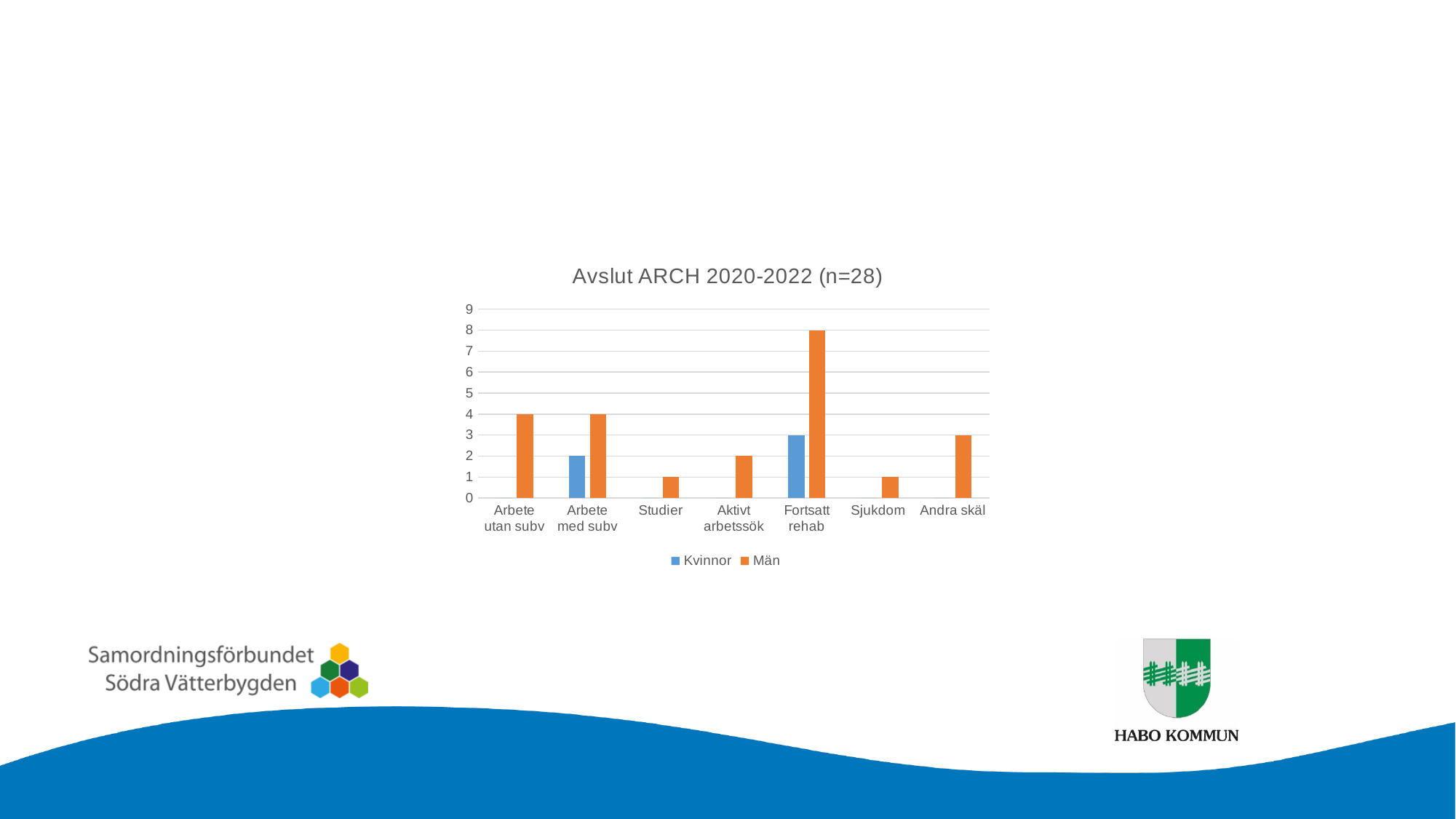
Which category has the highest value for Män? Fortsatt rehab What is the difference between the Män and Kvinnor values in the Fortsatt rehab category? 5 Is the value for Män in the Fortsatt rehab category greater or less than 5? greater What is the title of the chart? Avslut ARCH 2020-2022 (n=28) What kind of chart is shown on the slide? bar chart What is the value for Män in the Fortsatt rehab category? 8 Which category has the highest value for Kvinnor? Fortsatt rehab How many categories are shown on the x axis? 7 Which is larger, the Män value for Arbete utan subv or the Män value for Studier? Arbete utan subv What is the value for Kvinnor in the Arbete med subv category? 2 What is the value for Män in the Andra skäl category? 3 How many series does the legend list? 2